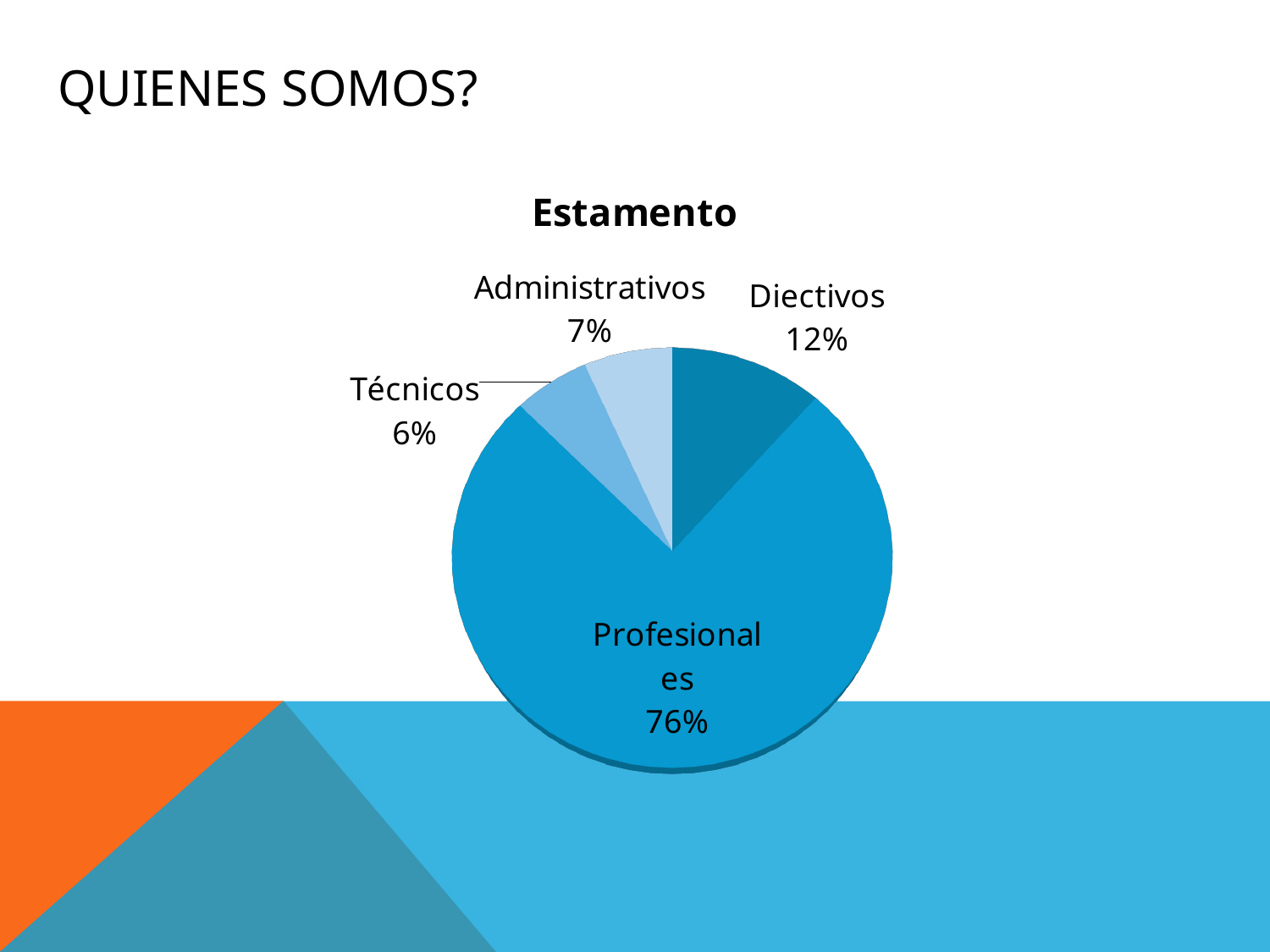
What is the difference in percentage points between Administrativos and Técnicos? 1 What type of chart is shown on the slide? pie chart What is the difference in percentage points between Profesionales and Diectivos? 64 What is the value shown for Diectivos? 12% Which category has the smallest slice of the pie? Técnicos Which is larger, the slice for Diectivos or the slice for Administrativos? Diectivos What share of the pie does Profesionales represent? 76% What is the title of the chart? Estamento What is the value shown for Técnicos? 6% How many categories are shown in the pie chart? 4 Which category has the largest slice of the pie? Profesionales What is the value shown for Administrativos? 7%